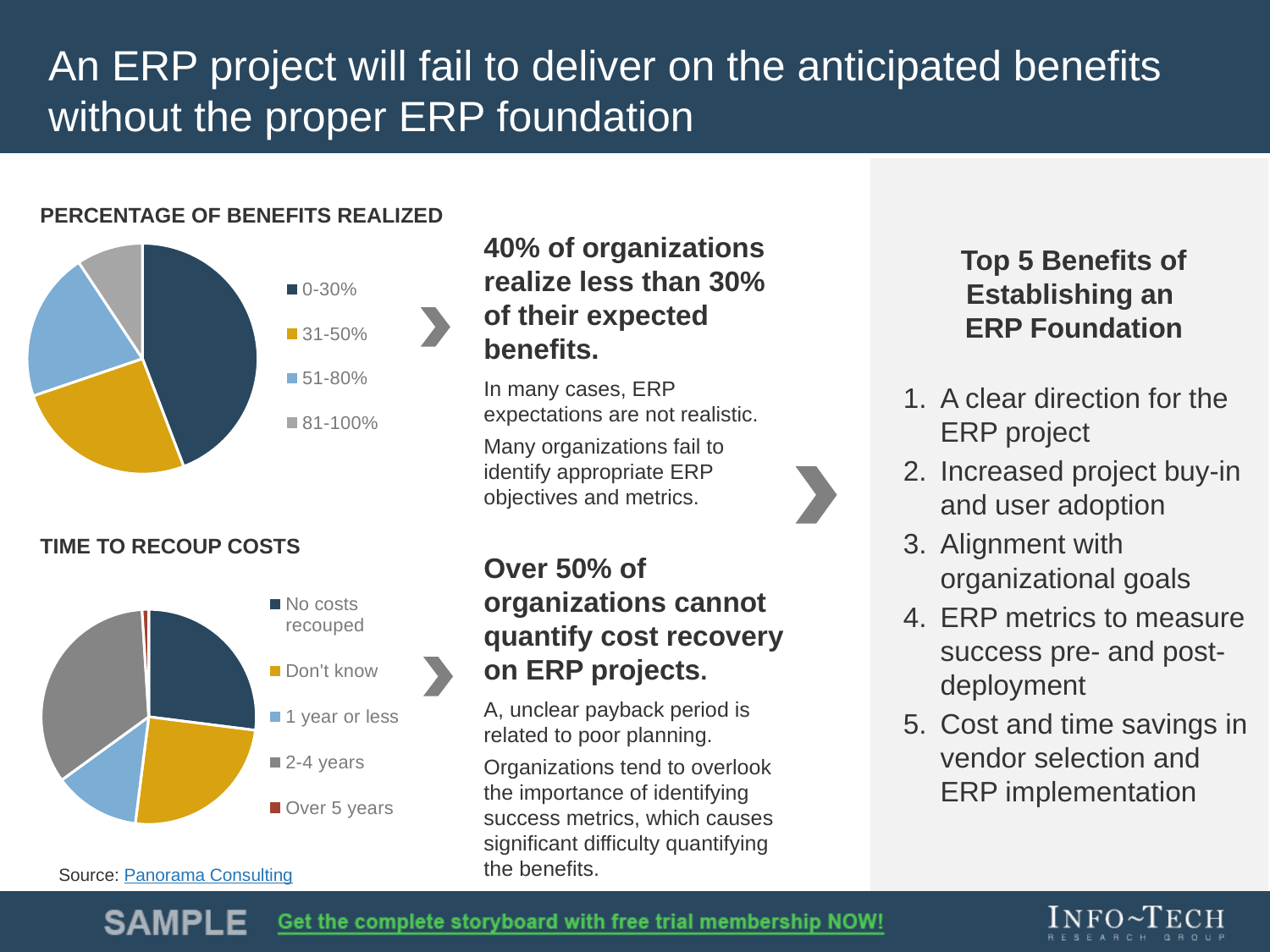
In the TIME TO RECOUP COSTS chart, which category has the smallest slice? Over 5 years In the TIME TO RECOUP COSTS chart, which slice is larger: No costs recouped or Over 5 years? No costs recouped In the TIME TO RECOUP COSTS chart, which slice is larger: Don't know or 1 year or less? Don't know How many categories does the TIME TO RECOUP COSTS pie chart show? 5 What colour is the 0-30% slice in the PERCENTAGE OF BENEFITS REALIZED chart? Dark blue In the PERCENTAGE OF BENEFITS REALIZED chart, which category has the largest slice? 0-30% In the PERCENTAGE OF BENEFITS REALIZED chart, which slice is larger: 0-30% or 81-100%? 0-30% What source is cited for the charts on the slide? Panorama Consulting What kind of chart is the TIME TO RECOUP COSTS chart? Pie chart In the PERCENTAGE OF BENEFITS REALIZED chart, which category has the smallest slice? 81-100% How many categories does the PERCENTAGE OF BENEFITS REALIZED pie chart show? 4 What kind of chart is the PERCENTAGE OF BENEFITS REALIZED chart? Pie chart